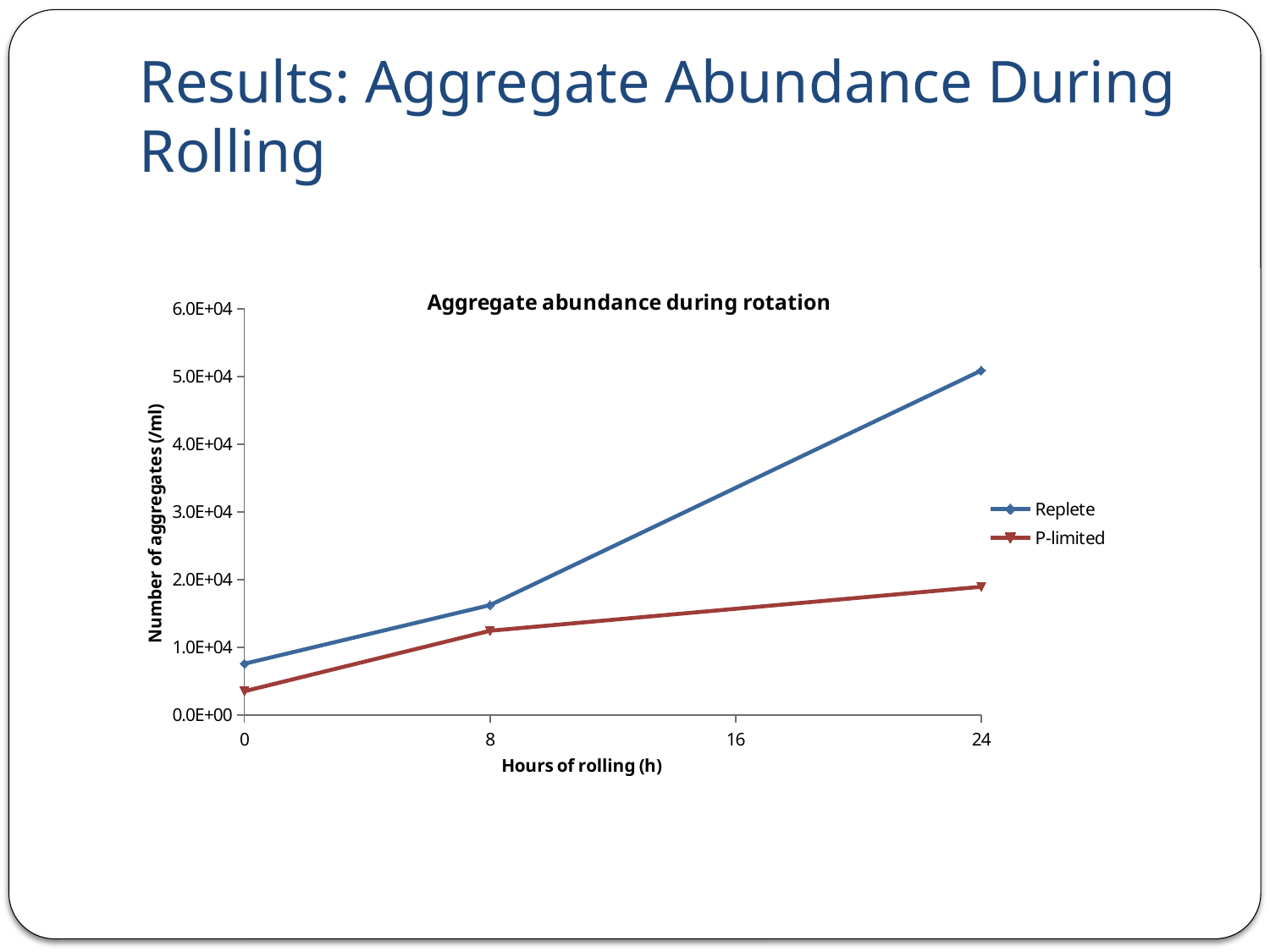
Is the value for P-limited at 24 hours greater or less than 3.0E+04? less At which hour of rolling does the Replete series reach its highest value? 24 Is the value for Replete at 24 hours greater or less than 4.0E+04? greater Is the value for Replete at 8 hours greater or less than 1.0E+04? greater At 24 hours of rolling, which series has the larger number of aggregates, Replete or P-limited? Replete How many time points are plotted for each series? 3 What is the title of the chart? Aggregate abundance during rotation How many series does the legend list? 2 Does the number of aggregates for P-limited rise or fall as hours of rolling increase? rise What kind of chart is shown on the slide? line chart